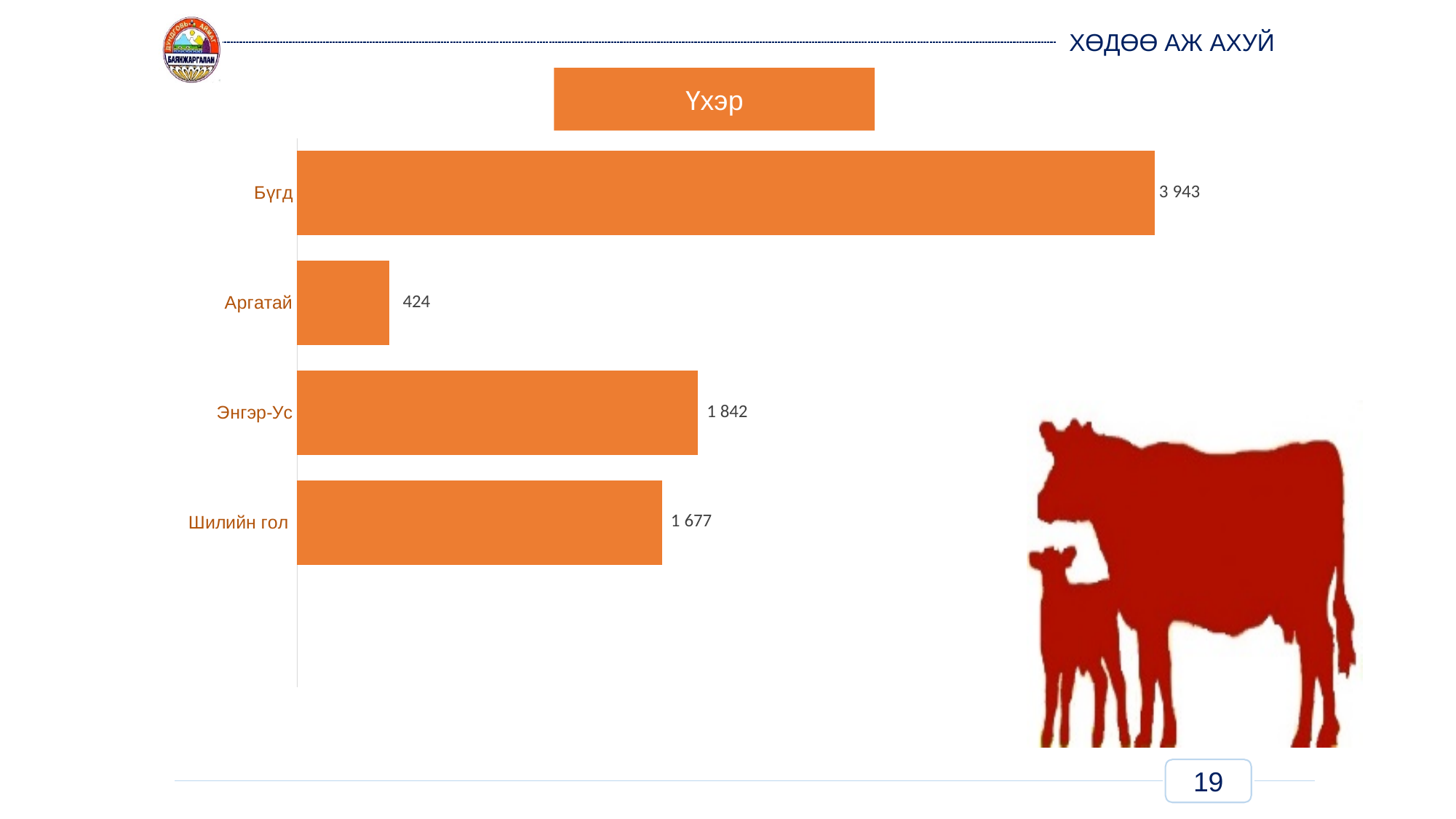
Which category has the highest value? Бүгд What is the value for Энгэр-Ус? 1 842 What is the value for Шилийн гол? 1 677 What is the value for Аргатай? 424 What is the difference between the values for Энгэр-Ус and Шилийн гол? 165 What is the value for Бүгд? 3 943 Which category has the lowest value? Аргатай What is the difference between the values for Энгэр-Ус and Аргатай? 1 418 What kind of chart is shown on the slide? bar chart How many categories are shown in the chart? 4 What is the title of the chart? Үхэр Which is larger, the value for Энгэр-Ус or the value for Шилийн гол? Энгэр-Ус